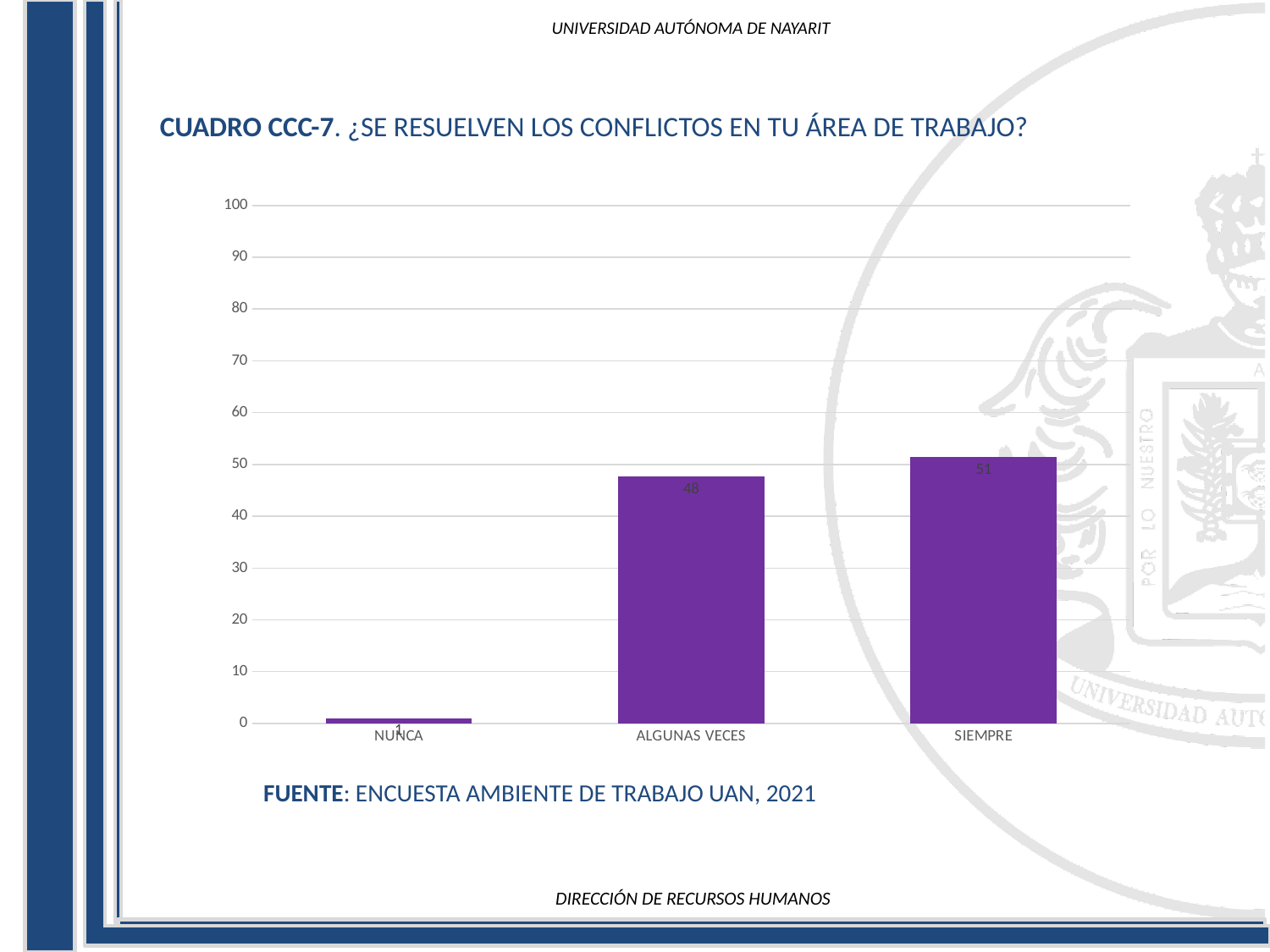
Which category has the highest value? SIEMPRE Is the value for ALGUNAS VECES greater or less than 40? greater How many categories are shown on the x axis? 3 Which is larger, the value for SIEMPRE or the value for ALGUNAS VECES? SIEMPRE Which category has the lowest value? NUNCA What is the value for SIEMPRE? 51 What is the difference between the values for SIEMPRE and ALGUNAS VECES? 3 What kind of chart is shown on the slide? bar chart What is the value for NUNCA? 1 What is the value for ALGUNAS VECES? 48 What is the title of the chart (the cuadro heading)? CUADRO CCC-7. ¿SE RESUELVEN LOS CONFLICTOS EN TU ÁREA DE TRABAJO? What is the difference between the values for ALGUNAS VECES and NUNCA? 47